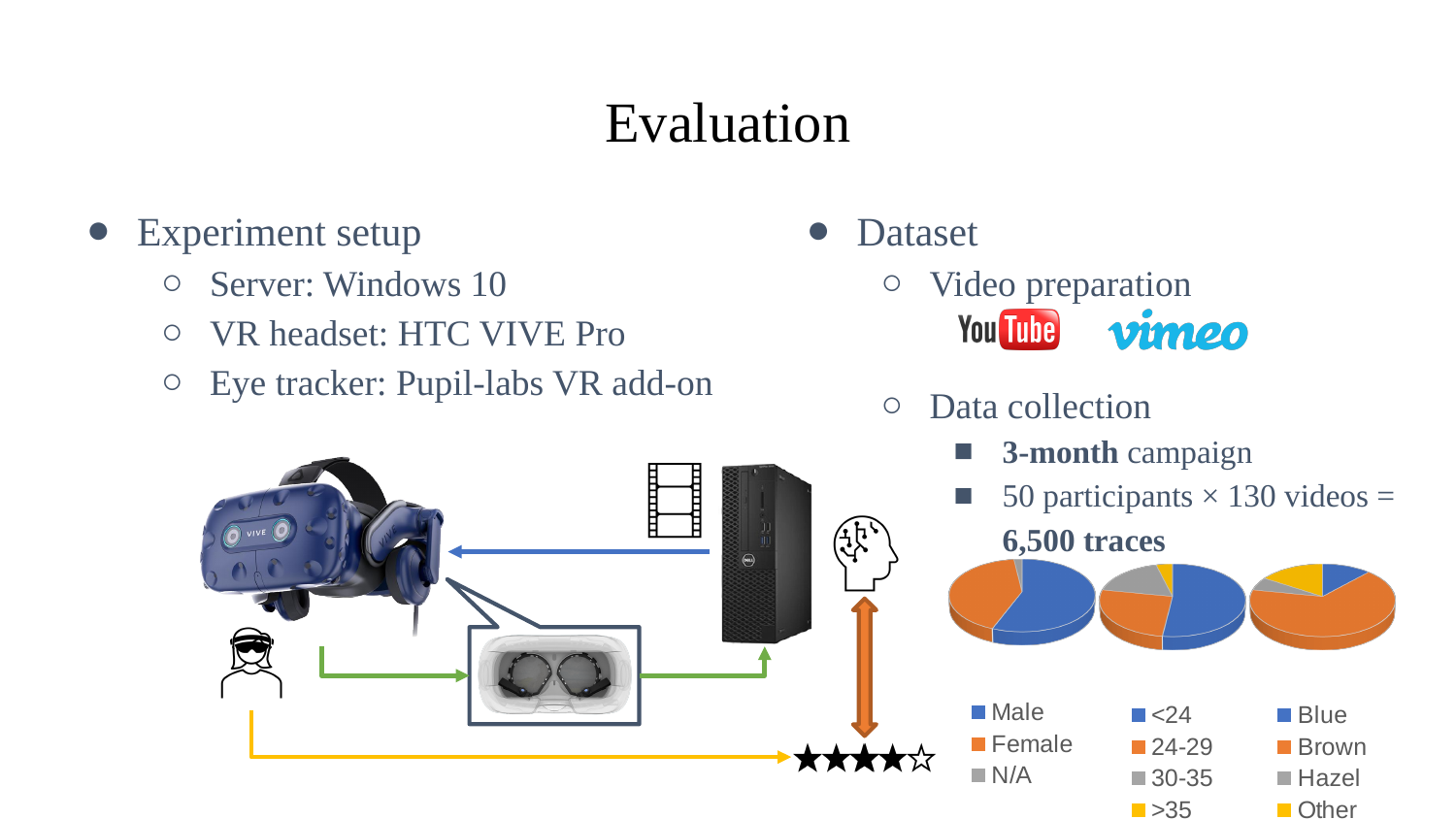
How many categories does the legend of the middle pie chart (age groups) list? 4 In the middle pie chart, which age group has the smallest slice? >35 In the right pie chart, which slice is larger: Brown or Blue? Brown What kind of chart is the left chart under 'Data collection' (the one with Male/Female/N/A legend)? pie chart In the left pie chart, which category has the smallest slice? N/A What colour represents 'Female' in the left pie chart's legend? orange How many categories does the legend of the right pie chart (eye colours) list? 4 In the right pie chart, which eye colour has the largest slice? Brown In the middle pie chart, which age group has the largest slice? <24 How many categories does the legend of the left pie chart (Male/Female/N/A) list? 3 In the middle pie chart, which slice is larger: 24-29 or >35? 24-29 In the right pie chart, which eye colour has the smallest slice? Hazel